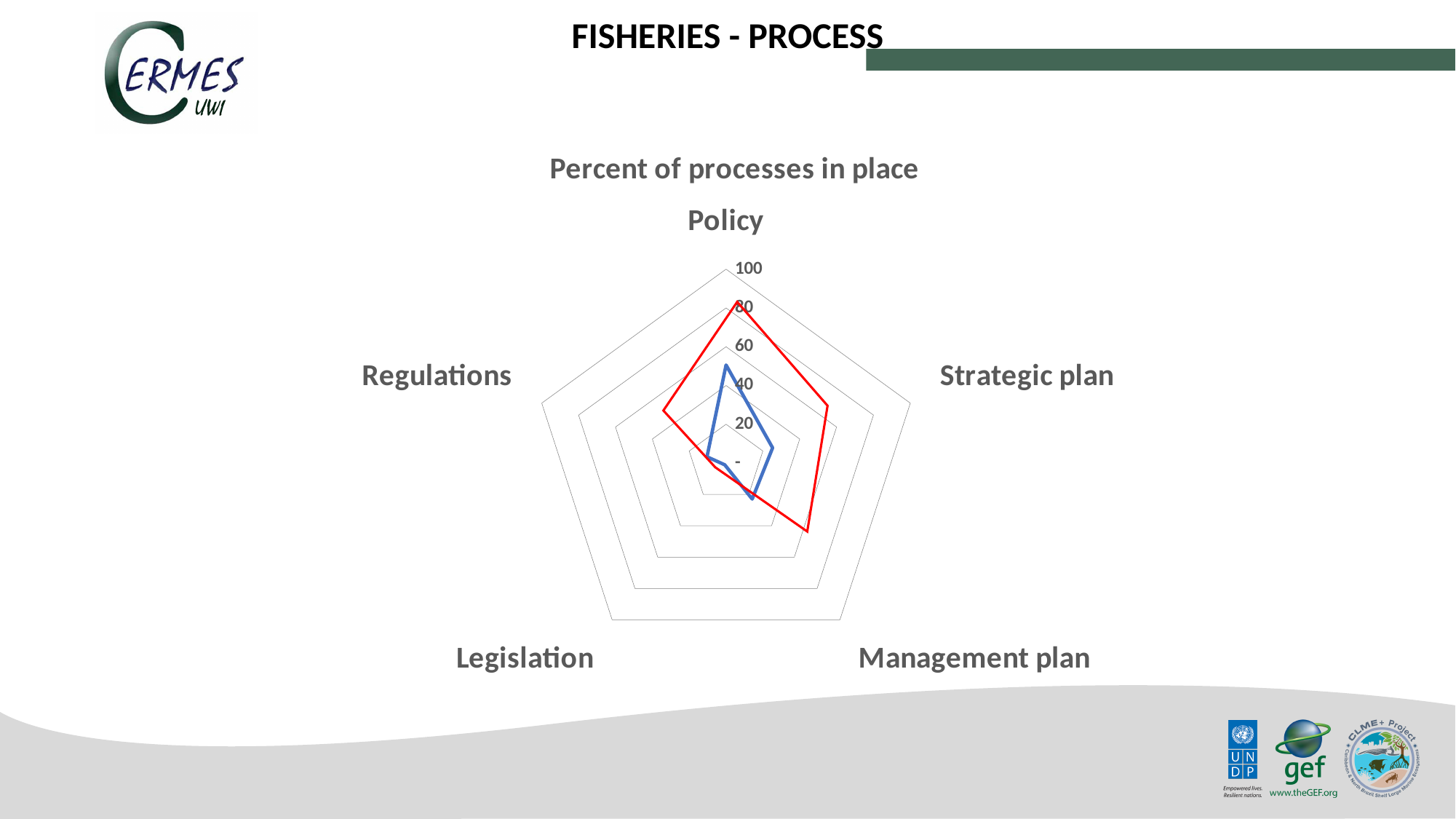
What kind of chart is shown on the slide? Radar chart Is the blue series value for Policy greater or less than 40? greater On which category does the red series have its lowest value? Legislation Is the red series value for Legislation greater or less than 20? less How many categories (axes) does the radar chart have? 5 What is the title of the chart? Percent of processes in place Is the red series value for Management plan greater or less than 40? greater What is the maximum value shown on the chart's axis scale? 100 For Strategic plan, which series has the larger value, the red or the blue? Red How many data series (lines) are plotted on the radar chart? 2